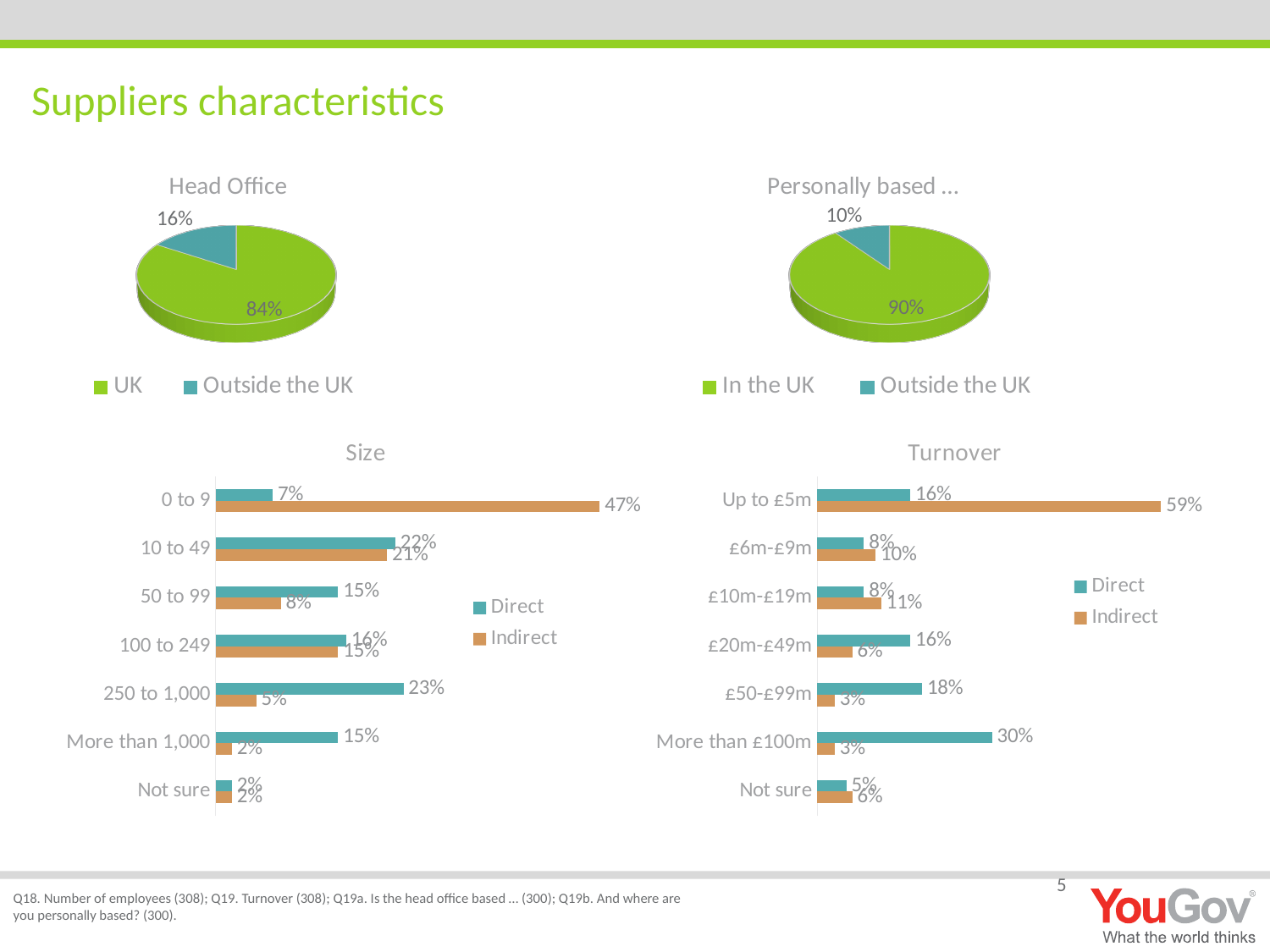
In the Size chart, which category has the highest Direct value? 250 to 1,000 In the Turnover chart, what is the Direct value for More than £100m? 30% In the Size chart, what is the Indirect value for 0 to 9? 47% In the Turnover chart, which is larger for £20m-£49m, Direct or Indirect? Direct In the Turnover chart, what is the difference between the Direct values for More than £100m and Up to £5m? 14% In the Head Office pie chart, what share is UK? 84% In the Personally based pie chart, what share is Outside the UK? 10% In the Turnover chart, which category has the highest Indirect value? Up to £5m In the Size chart, what is the difference between the Indirect and Direct values for 0 to 9? 40% What kind of chart is the Head Office chart? Pie chart How many series does the legend of the Size chart list? 2 How many categories are shown in the Turnover chart? 7